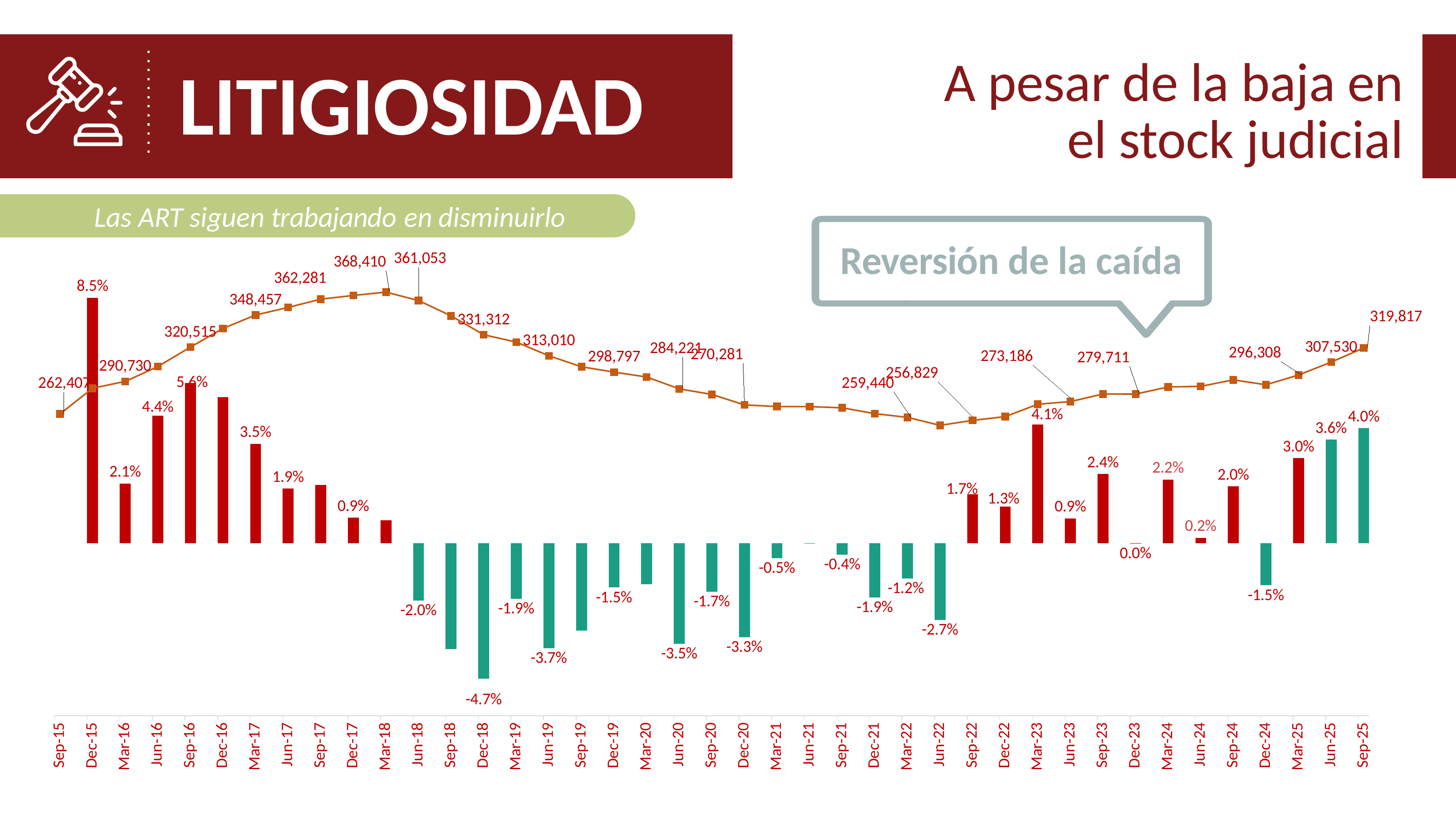
What is the stock value labelled on the line for Sep-15? 262,407 What is the percentage change shown for Dec-18? -4.7% Which has the larger percentage change, Mar-25 or Jun-25? Jun-25 What is the difference between the line values for Sep-25 (319,817) and Sep-15 (262,407)? 57,410 Which quarter has the highest bar (percentage change) in the chart? Dec-15 What text appears in the callout box above the line chart? Reversión de la caída What is the stock value labelled on the line for Sep-25? 319,817 What is the percentage change shown for Dec-15? 8.5% What is the percentage change shown for Sep-25? 4.0% What is the highest stock value labelled on the line? 368,410 Which quarter has the lowest bar (most negative percentage change)? Dec-18 What kind of chart is shown on the slide? A combined bar and line chart